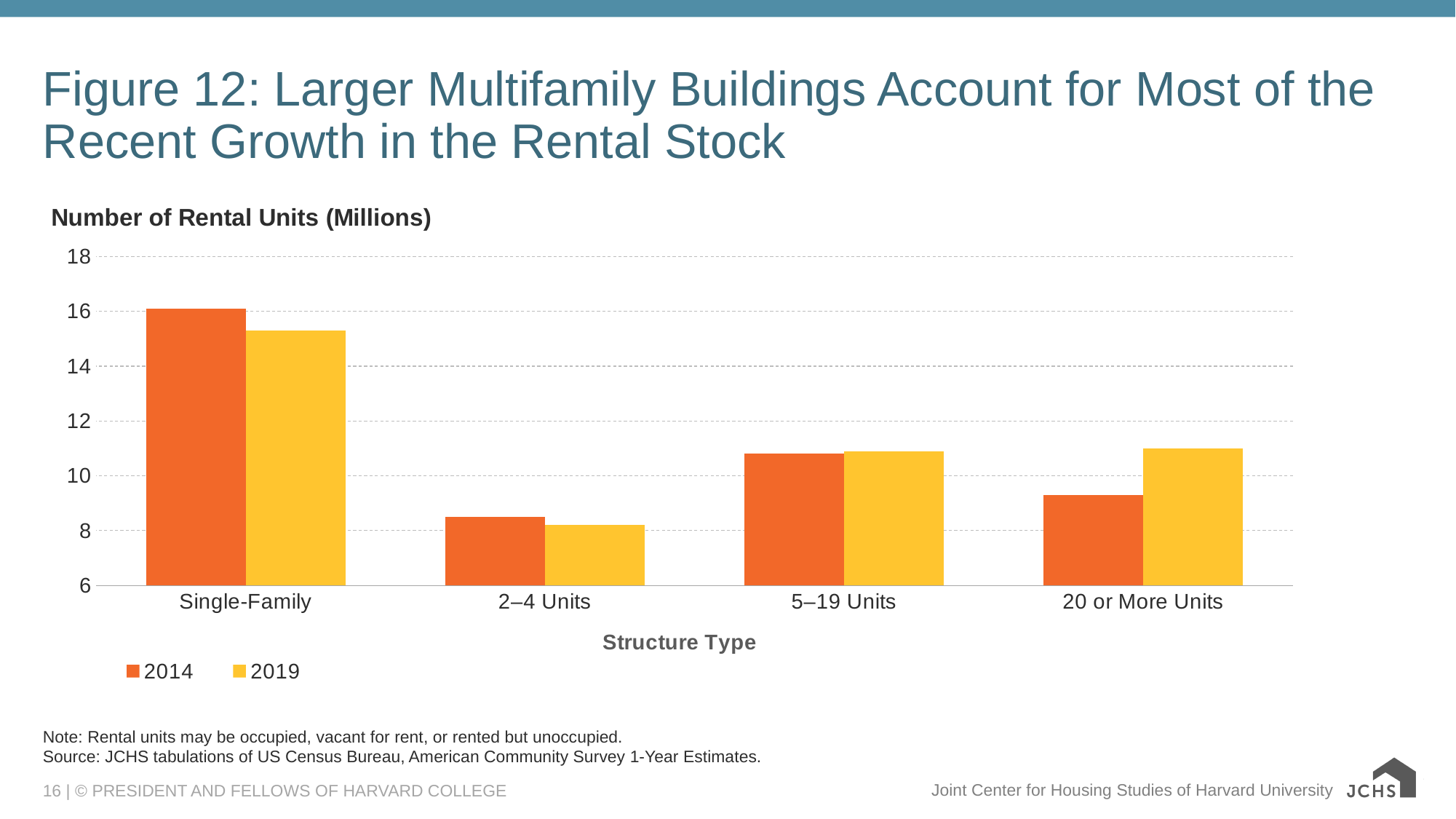
For Single-Family, which year has the larger number of rental units, 2014 or 2019? 2014 What is the label of the x axis? Structure Type Is the value for Single-Family in 2019 greater or less than 16? less Which structure type has the lowest number of rental units in 2019? 2–4 Units Which structure type has the highest number of rental units in 2014? Single-Family How many series does the legend list? 2 How many structure type categories are shown on the x axis? 4 Is the value for 20 or More Units in 2019 greater or less than 10? greater Is the value for 20 or More Units in 2014 greater or less than 10? less For 20 or More Units, which year has the larger number of rental units, 2014 or 2019? 2019 What kind of chart is shown on the slide? bar chart